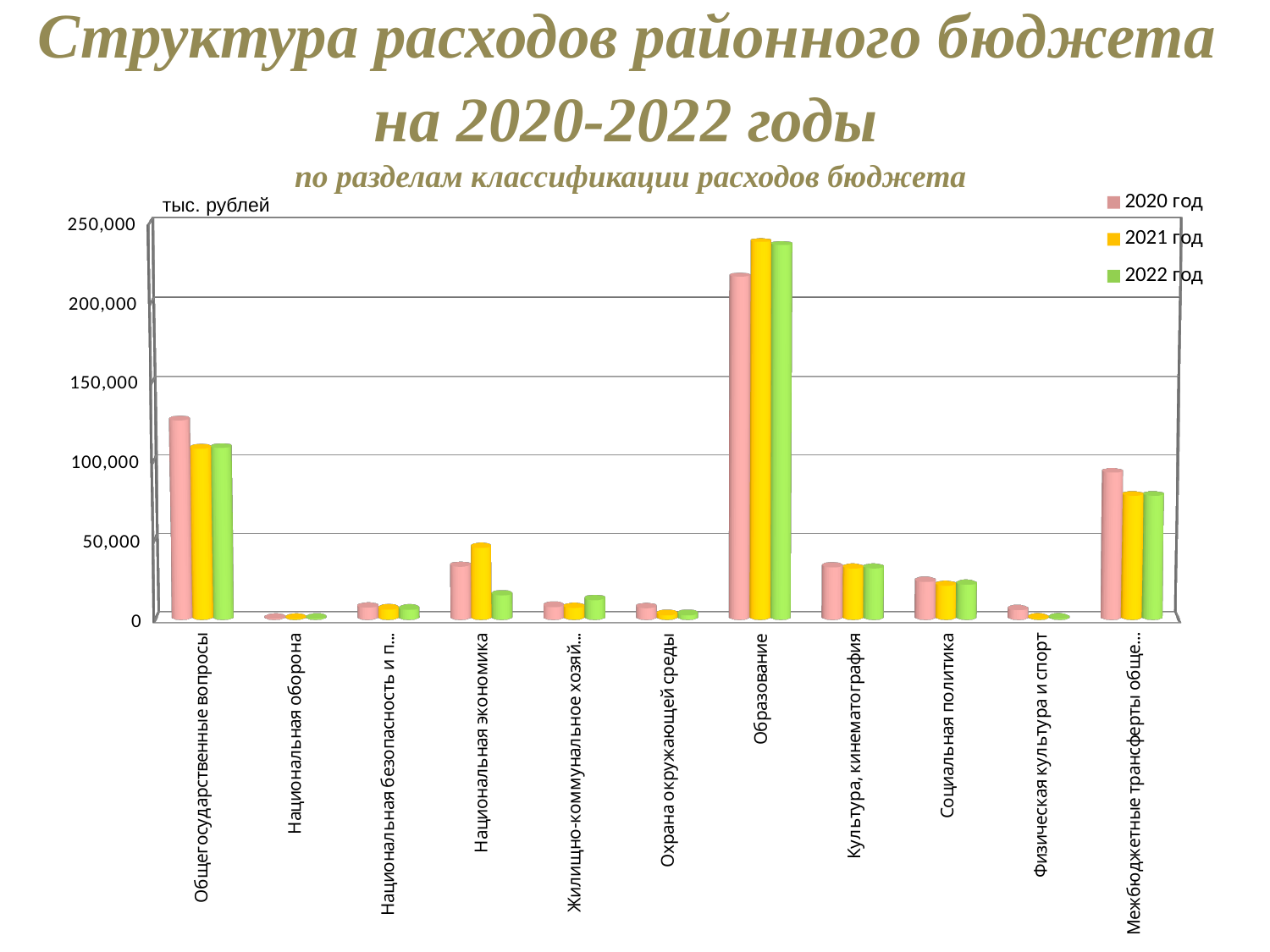
Which is larger for Общегосударственные вопросы: the value for 2020 год or 2022 год? 2020 год Is the value for Образование in 2021 год greater or less than 200,000? greater Which category has the lowest value for 2020 год? Национальная оборона Is the value for Общегосударственные вопросы in 2020 год greater or less than 100,000? greater Which series is shown in yellow in the legend? 2021 год Which is larger for Национальная экономика: the value for 2021 год or 2022 год? 2021 год What unit is shown at the top of the vertical axis? тыс. рублей Which category has the highest value for 2021 год? Образование Is the value for Социальная политика in 2020 год greater or less than 50,000? less What kind of chart is shown on the slide? bar chart How many series does the legend list? 3 How many categories are shown along the x axis? 11